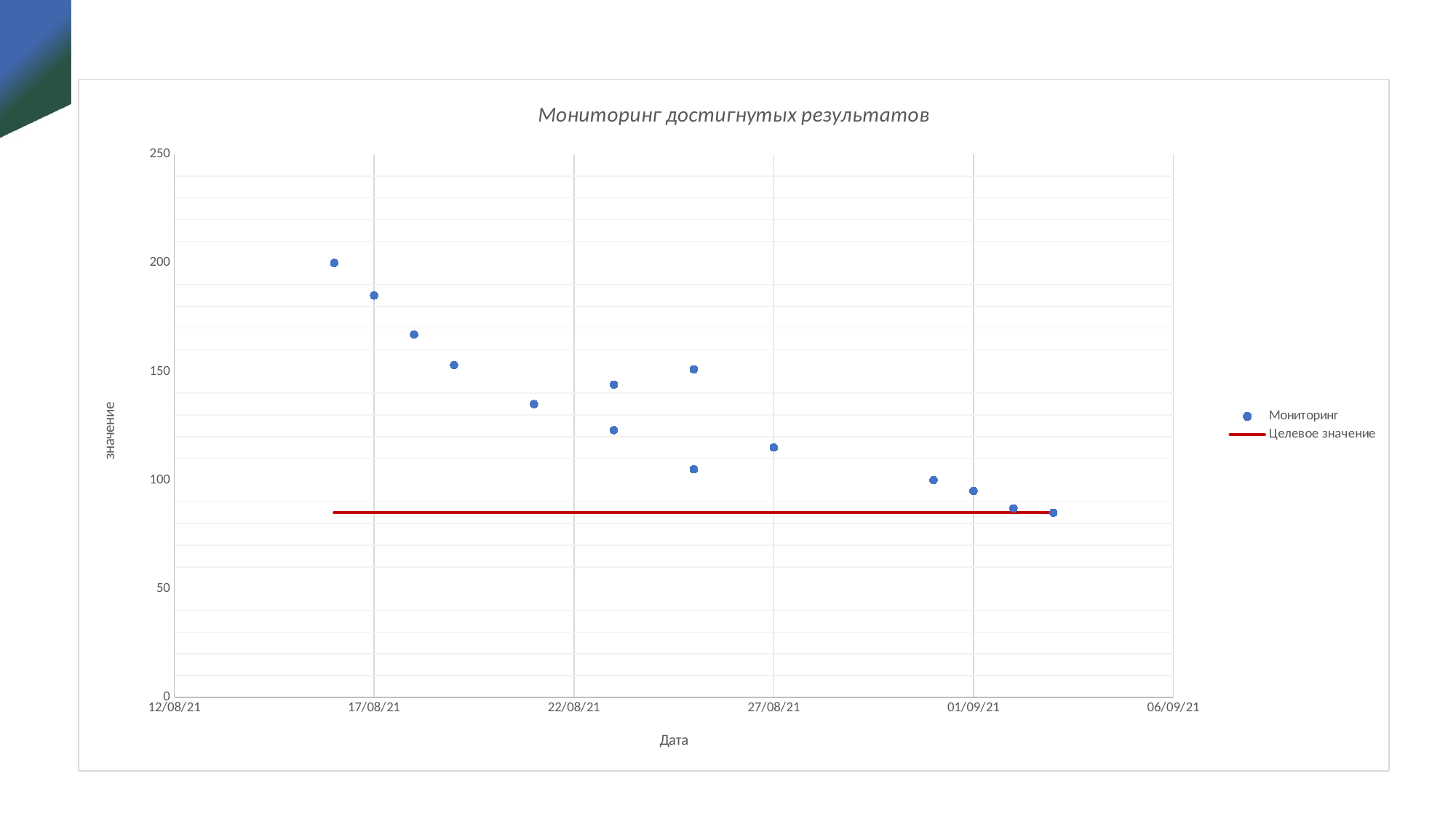
How many series does the legend list? 2 Which Мониторинг point has the highest value: the earliest one or the latest one? The earliest one Do the Мониторинг values generally rise or fall along the date axis? Fall Is the latest (rightmost) Мониторинг point greater or less than 100? less How many Мониторинг points are plotted on the chart? 14 Is the Мониторинг point near 27/08/21 greater or less than 100? greater What are the two entries in the chart legend? Мониторинг, Целевое значение What kind of chart is shown on the slide? Scatter chart Is the Целевое значение line greater or less than 100? less What is the title of the chart? Мониторинг достигнутых результатов What is the maximum value shown on the vertical axis? 250